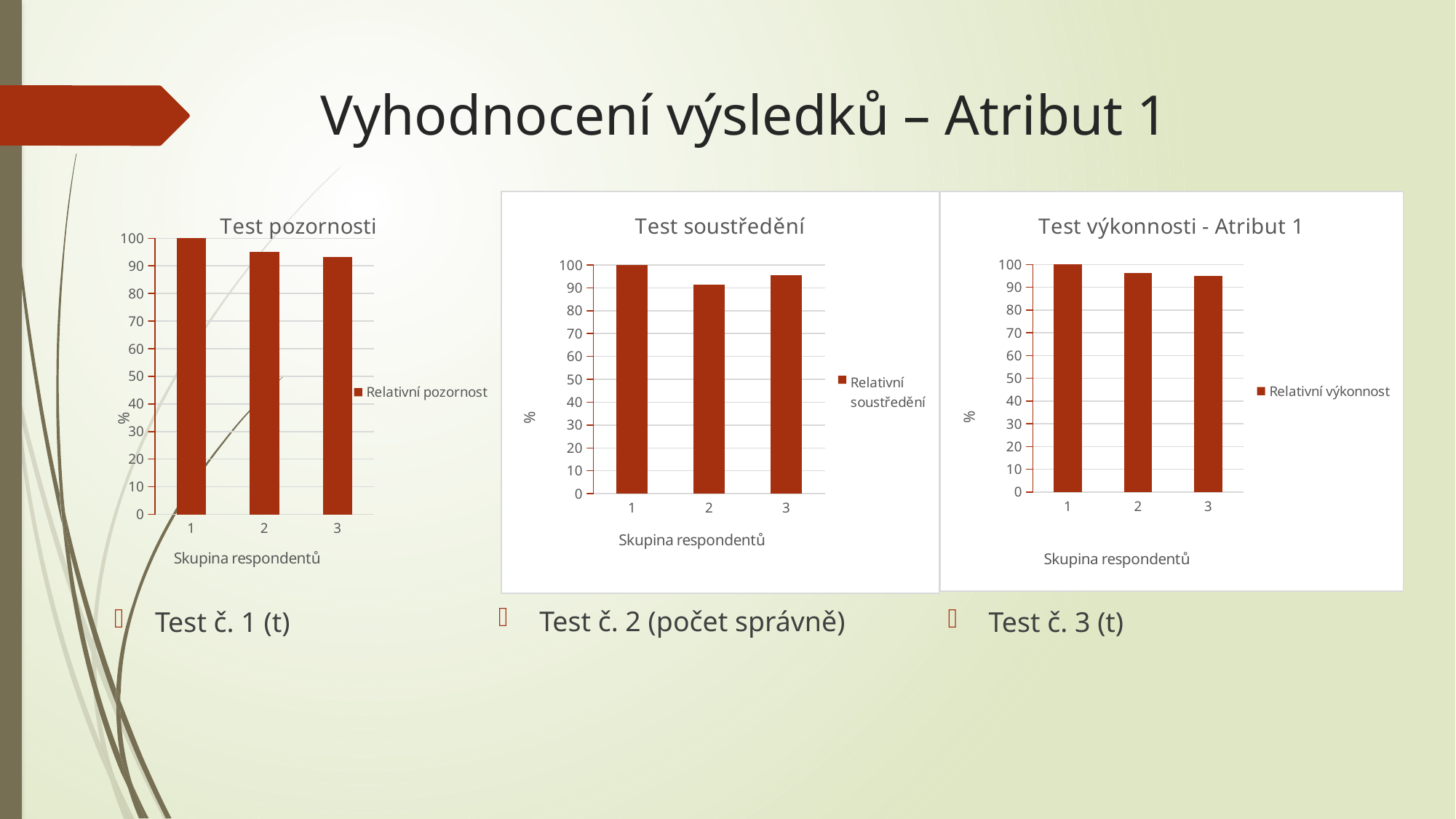
In the chart titled "Test pozornosti", do the values rise or fall from group 1 to group 3? fall In the chart titled "Test soustředění", is the value for group 3 greater or less than 90? greater In the chart titled "Test soustředění", which is larger, the value for group 2 or group 3? group 3 In the chart titled "Test výkonnosti - Atribut 1", which group has the highest value? 1 In the chart titled "Test výkonnosti - Atribut 1", is the value for group 2 greater or less than 100? less In the chart titled "Test soustředění", which group has the lowest value? 2 What kind of chart is the chart titled "Test soustředění"? bar chart In the chart titled "Test pozornosti", which group has the lowest value? 3 In the chart titled "Test pozornosti", what is the value for group 1? 100 How many groups of respondents are shown in the chart titled "Test pozornosti"? 3 How many series does the legend of the chart titled "Test výkonnosti - Atribut 1" list? 1 In the chart titled "Test soustředění", what is the value for group 1? 100